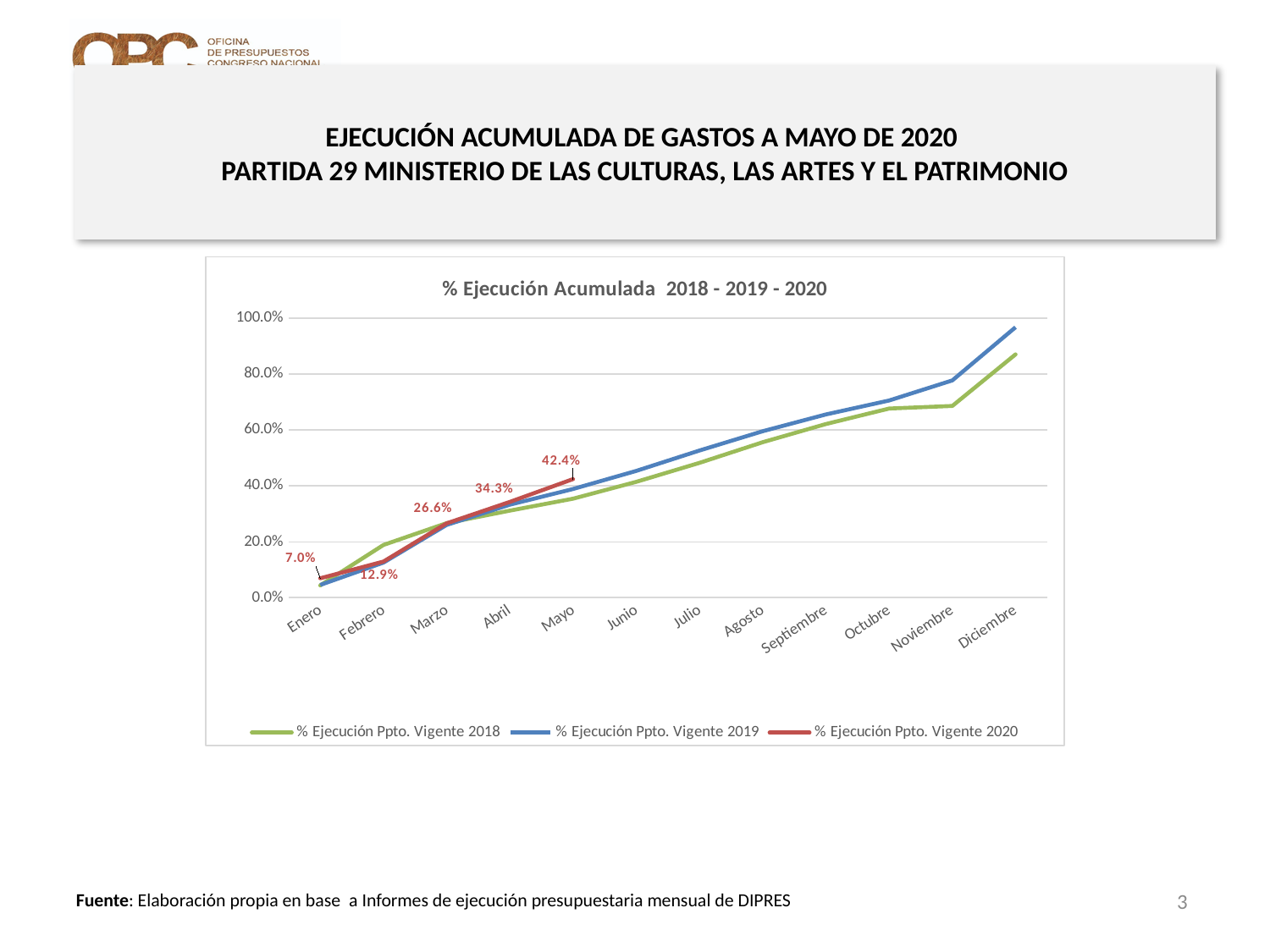
What kind of chart is shown on the slide? Line chart In Diciembre, which series has the higher value: 2018 or 2019? % Ejecución Ppto. Vigente 2019 How many months are shown on the x axis? 12 In the 2020 series, by how many percentage points does the value rise from Abril to Mayo? 8.1 percentage points Among the labelled 2020 months, which month has the highest value? Mayo What is the value for Enero in the % Ejecución Ppto. Vigente 2020 series? 7.0% What is the value for Mayo in the % Ejecución Ppto. Vigente 2020 series? 42.4% How many series does the legend list? 3 Is the value for Diciembre in the % Ejecución Ppto. Vigente 2019 series greater or less than 80.0%? greater What is the value for Marzo in the % Ejecución Ppto. Vigente 2020 series? 26.6% Is the value for Junio in the % Ejecución Ppto. Vigente 2019 series greater or less than 60.0%? less In the 2020 series, what is the difference between the Marzo and Febrero values? 13.7 percentage points